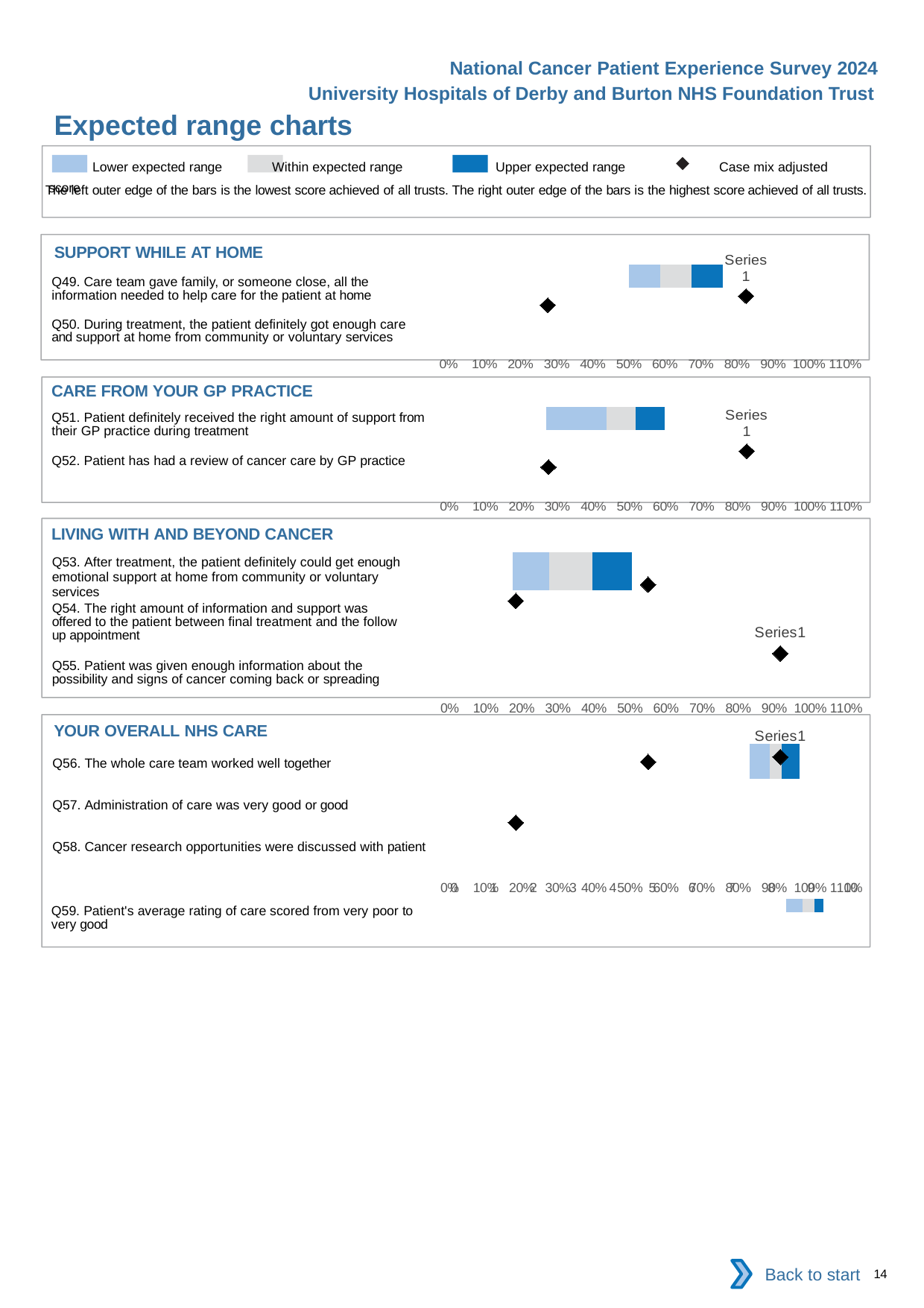
What is the highest percentage tick shown on the x axis of the 'CARE FROM YOUR GP PRACTICE' chart? 110% How many diamond markers are plotted in the 'SUPPORT WHILE AT HOME' chart? 2 In the 'CARE FROM YOUR GP PRACTICE' chart, is the leftmost diamond marker greater or less than 40%? less How many entries does the legend at the top of the slide list? 4 What kind of chart is used in the 'SUPPORT WHILE AT HOME' section? bar chart In the 'SUPPORT WHILE AT HOME' chart, is the rightmost diamond marker greater or less than 70%? greater In the 'YOUR OVERALL NHS CARE' chart, is the leftmost diamond marker greater or less than 30%? less According to the legend, what does the diamond marker represent? Case mix adjusted score How many questions are listed in the 'LIVING WITH AND BEYOND CANCER' section? 3 How many questions are listed in the 'YOUR OVERALL NHS CARE' section? 4